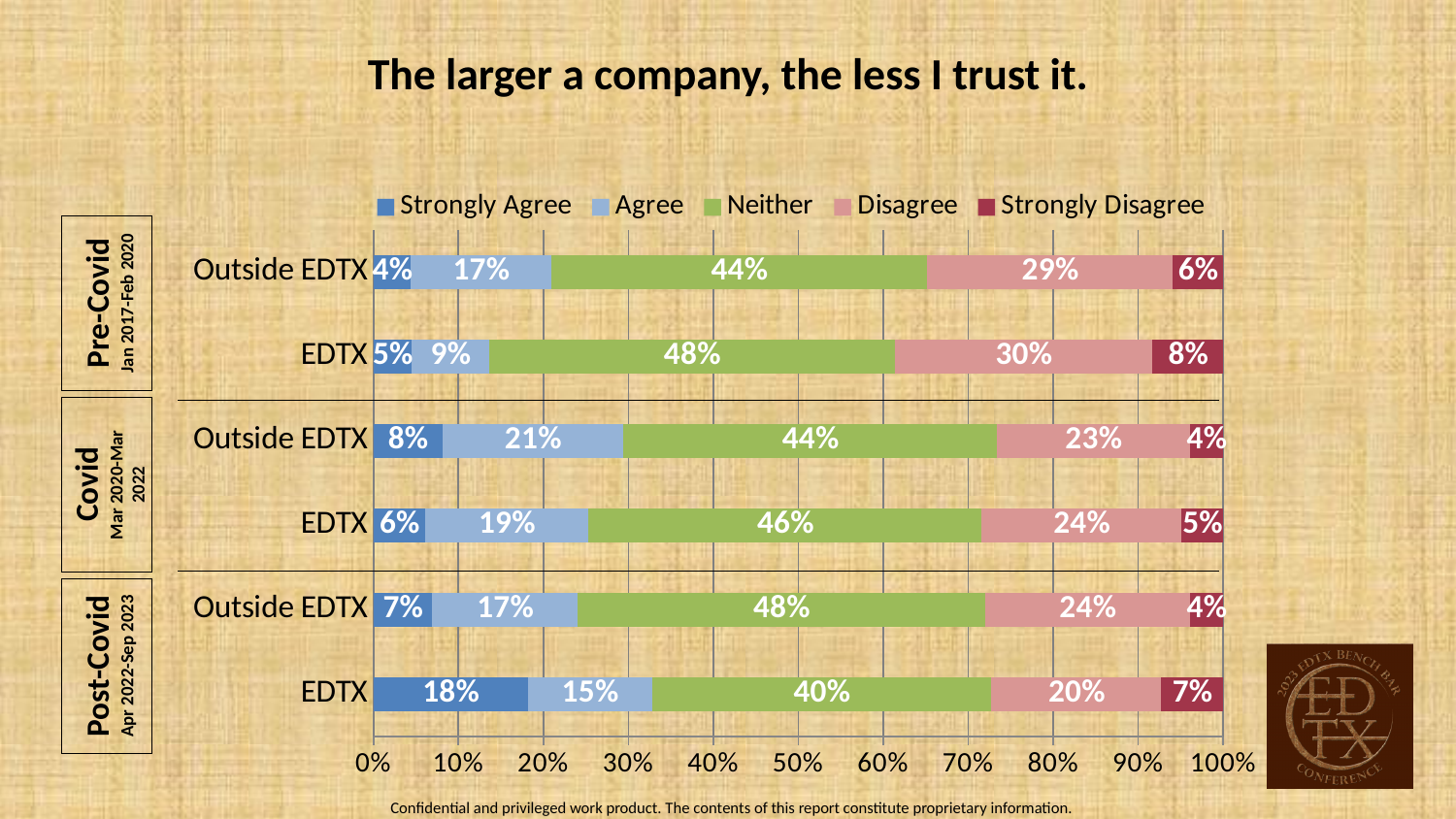
What is the Neither value for Pre-Covid EDTX? 48% What is the combined Strongly Agree and Agree value for Post-Covid EDTX? 33% Which bar has the lowest Neither value? Post-Covid EDTX What is the Disagree value for Covid Outside EDTX? 23% How many bars are plotted in the chart? 6 What is the difference between the Agree values for Covid Outside EDTX and Pre-Covid EDTX? 12% Which bar has the highest Strongly Agree value? Post-Covid EDTX How many series does the legend list? 5 What kind of chart is shown on the slide? Stacked bar chart What is the title of the chart? The larger a company, the less I trust it. What is the Strongly Agree value for Post-Covid EDTX? 18% Which is larger, the Disagree value for Pre-Covid EDTX or for Post-Covid EDTX? Pre-Covid EDTX